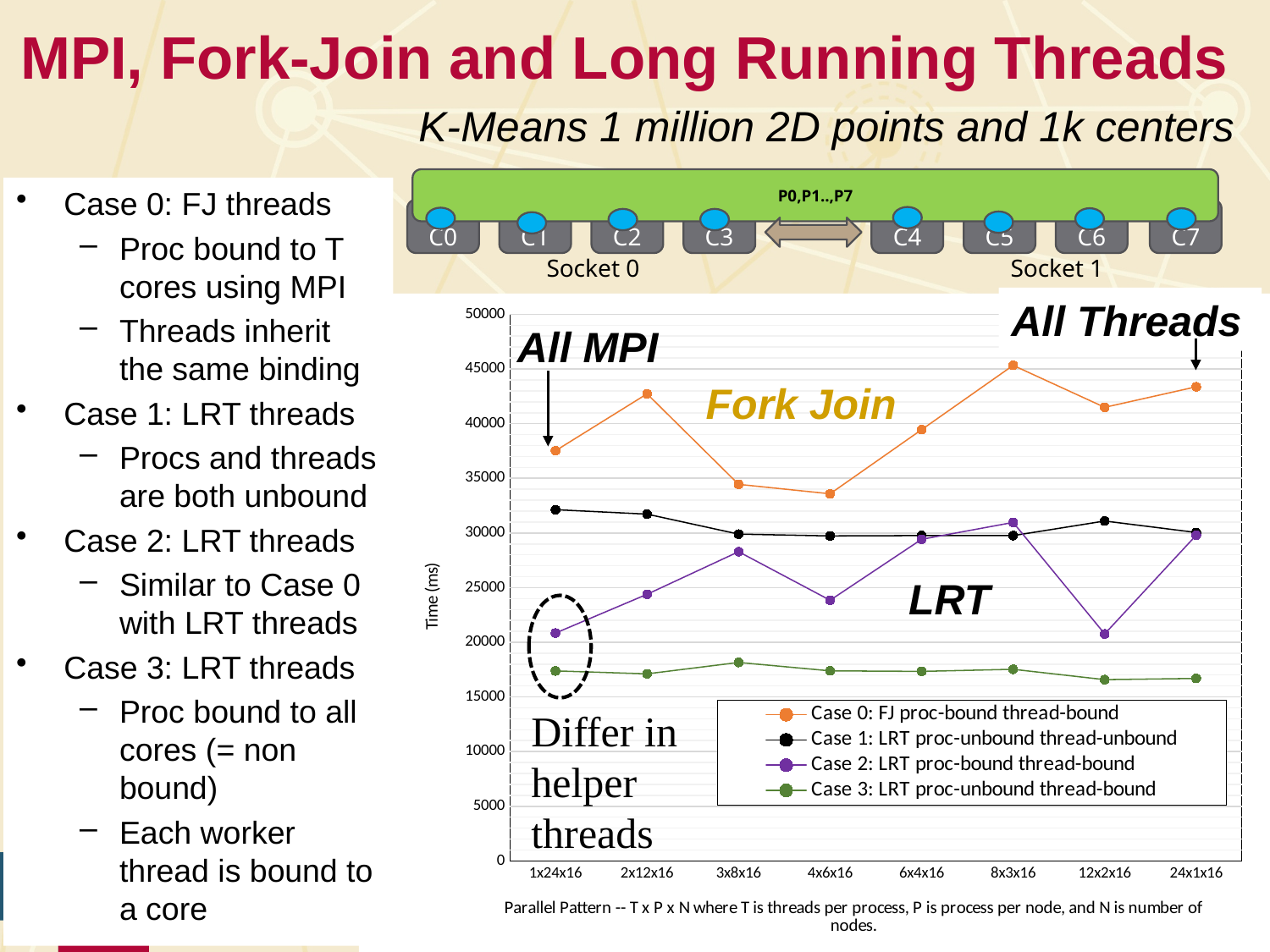
What is the label on the y axis of the chart? Time (ms) How many parallel pattern categories are shown on the x axis of the chart? 8 Is the value for Case 1: LRT proc-unbound thread-unbound at 1x24x16 greater or less than 30000? greater What kind of chart is shown on the slide? line chart Is the value for Case 3: LRT proc-unbound thread-bound at 1x24x16 greater or less than 20000? less Which series has the lowest value at 24x1x16? Case 3: LRT proc-unbound thread-bound How many series does the chart legend list? 4 For Case 0: FJ proc-bound thread-bound, at which parallel pattern is the time highest? 8x3x16 At 4x6x16, which is larger: the value for Case 1: LRT proc-unbound thread-unbound or the value for Case 2: LRT proc-bound thread-bound? Case 1: LRT proc-unbound thread-unbound Which series has the highest value at 1x24x16? Case 0: FJ proc-bound thread-bound Is the value for Case 0: FJ proc-bound thread-bound at 8x3x16 greater or less than 40000? greater